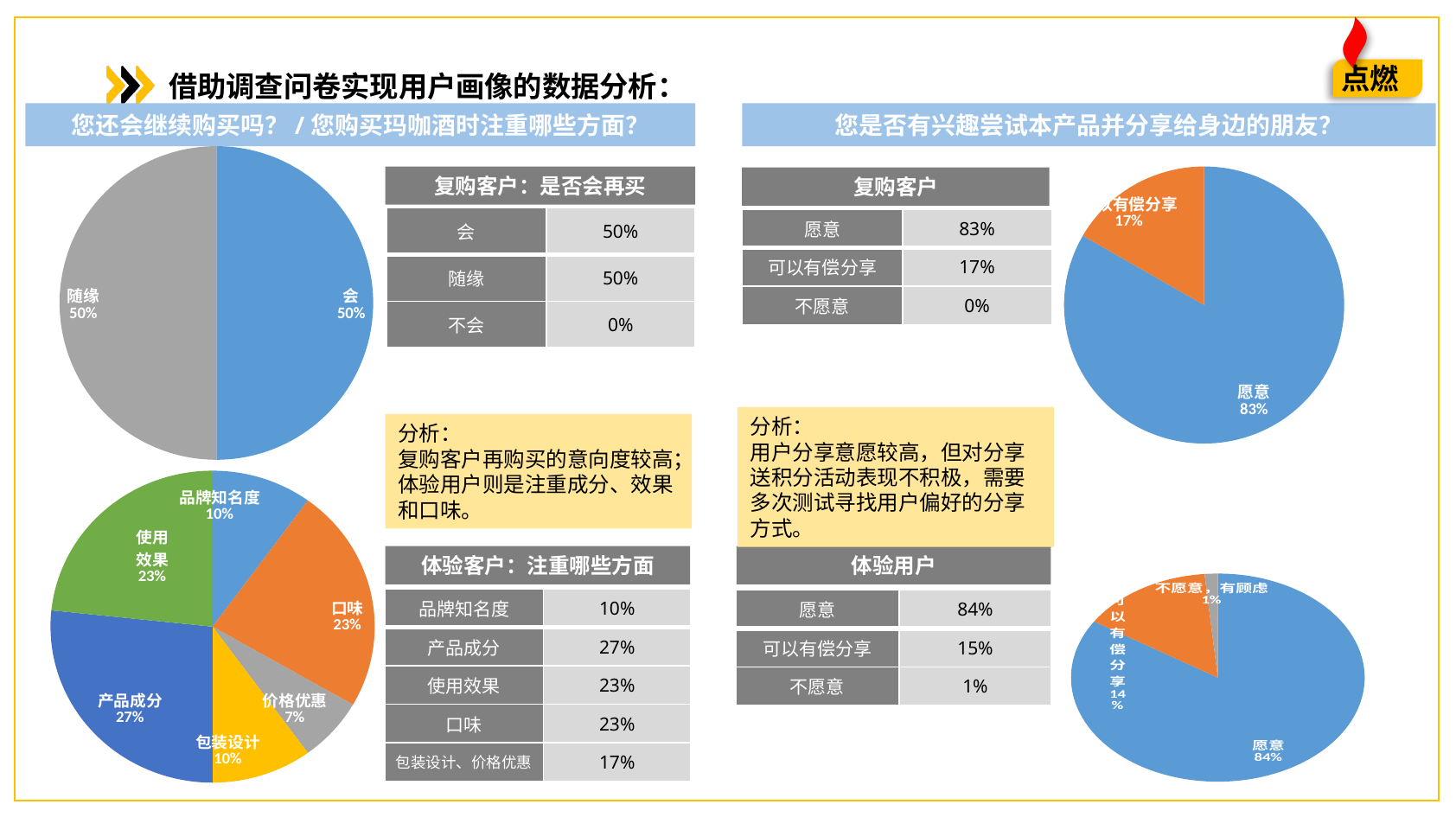
In the bottom-left pie chart, what is the difference between the shares of 产品成分 and 品牌知名度? 17% In the top-left pie chart, what percentage is labelled for 会? 50% In the bottom-left pie chart, what percentage is labelled for 产品成分? 27% In the bottom-left pie chart, which category has the smallest share? 价格优惠 What kind of chart is the top-left chart on the slide? Pie chart In the top-right pie chart, what percentage is labelled for 可以有偿分享? 17% In the bottom-left pie chart, how many slices are there? 6 In the bottom-right pie chart, what percentage is labelled for 愿意? 84% In the bottom-left pie chart, which is larger: 口味 or 包装设计? 口味 In the top-left pie chart, what percentage is labelled for 随缘? 50% In the bottom-left pie chart, which category has the largest share? 产品成分 In the top-right pie chart, what percentage is labelled for 愿意? 83%